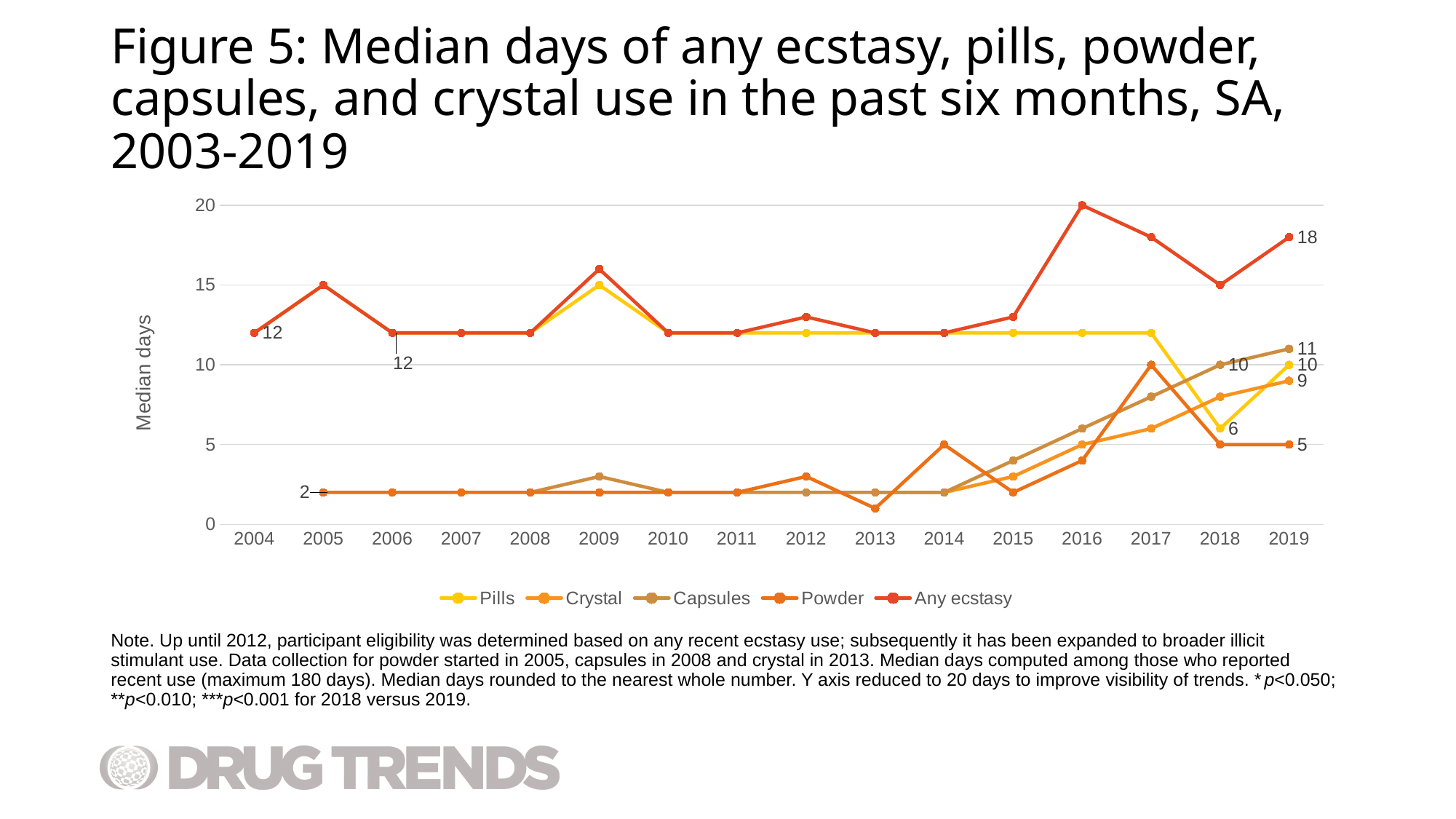
What is the median days value for Crystal in 2019? 9 What is the median days value for Pills in 2018? 6 What is the median days value for Any ecstasy in 2019? 18 By how much did the median days for Pills increase from 2018 to 2019? 4 How many series does the legend list? 5 How many years are shown on the x axis? 16 What kind of chart is shown on the slide? line chart Is the value for Powder in 2013 greater or less than 5? less In 2019, which series has the higher value: Capsules or Crystal? Capsules In which year does the Any ecstasy line reach its highest value? 2016 What is the median days value for Powder in 2019? 5 What is the median days value for Capsules in 2019? 11